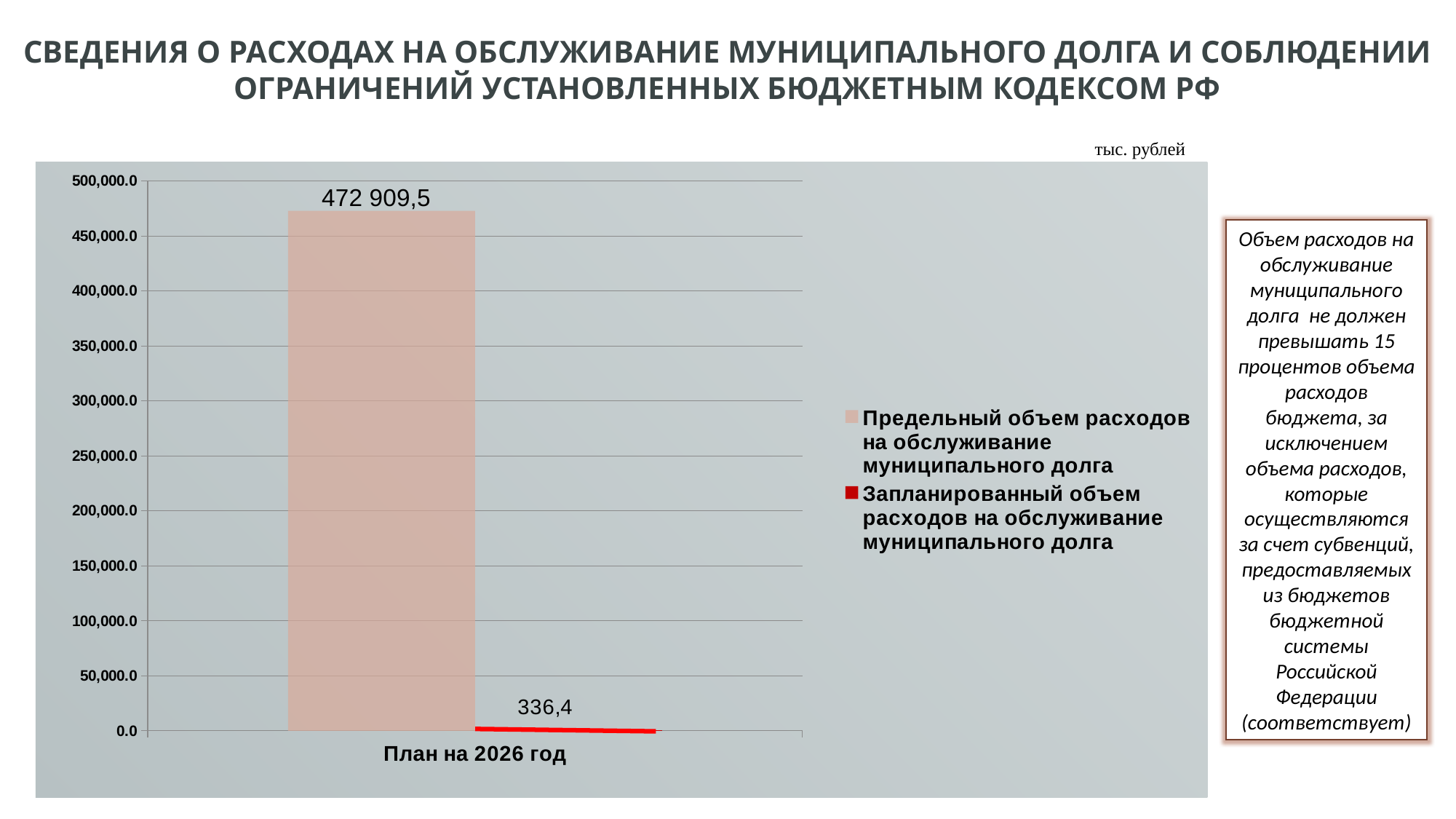
How many categories are shown on the x axis of the chart? 1 How many series does the legend list? 2 What kind of chart is shown on the slide? bar chart Which series has the higher value for "План на 2026 год"? Предельный объем расходов на обслуживание муниципального долга What is the value of the series "Запланированный объем расходов на обслуживание муниципального долга" for "План на 2026 год"? 336,4 What is the difference between the value for "Предельный объем расходов на обслуживание муниципального долга" and the value for "Запланированный объем расходов на обслуживание муниципального долга"? 472 573,1 Which series has the lowest value on the chart? Запланированный объем расходов на обслуживание муниципального долга What unit is indicated above the chart? тыс. рублей Is the value for "Запланированный объем расходов на обслуживание муниципального долга" greater or less than 50,000.0? less What is the value of the series "Предельный объем расходов на обслуживание муниципального долга" for "План на 2026 год"? 472 909,5 Is the value for "Предельный объем расходов на обслуживание муниципального долга" greater or less than 450,000.0? greater What is the category label shown on the x axis of the chart? План на 2026 год